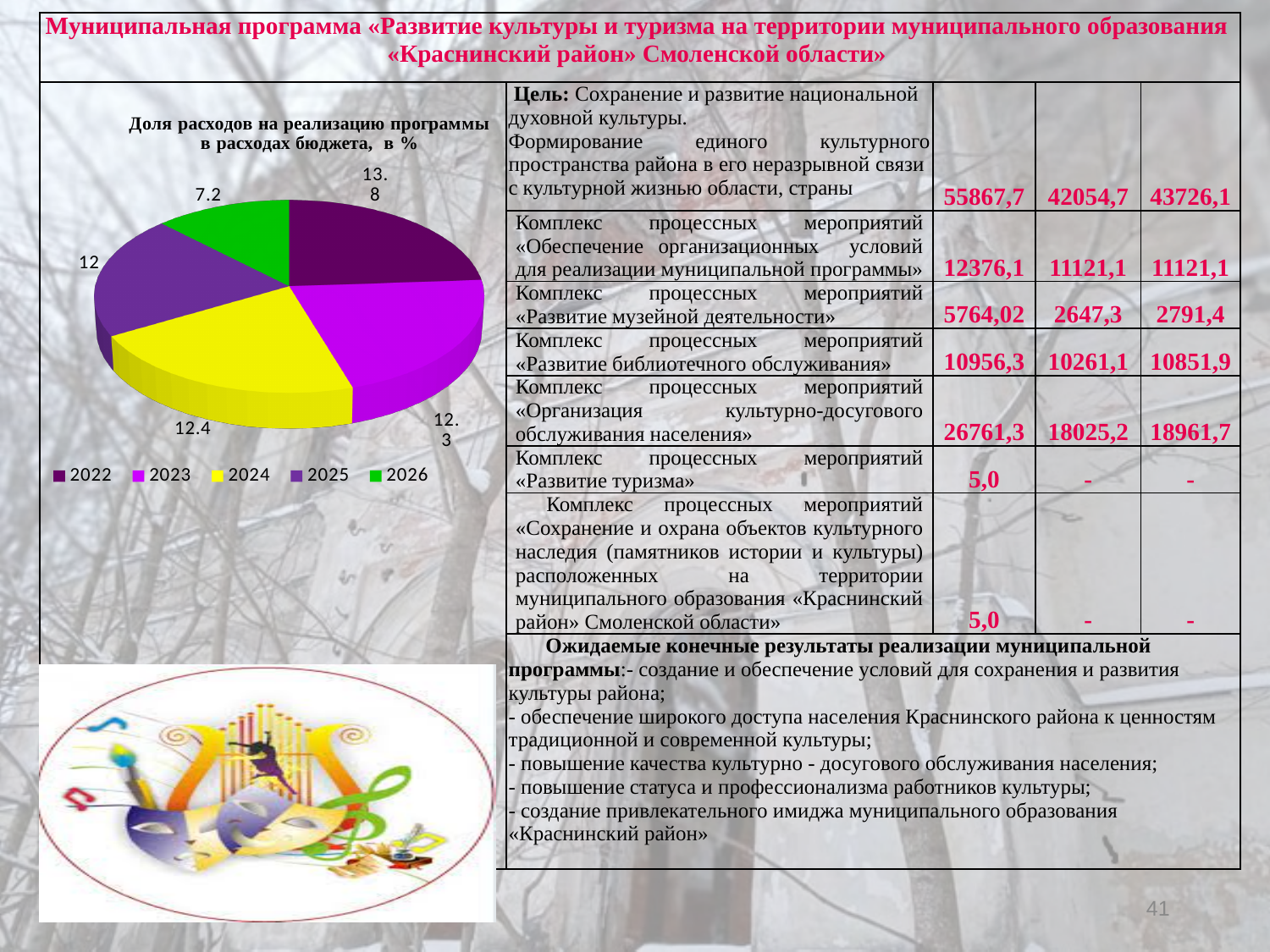
What is the value shown for 2024 in the pie chart? 12.4 What is the difference between the values for 2022 and 2026 in the pie chart? 6.6 Which year has the largest slice in the pie chart? 2022 What is the value shown for 2025 in the pie chart? 12 What is the value shown for 2022 in the pie chart? 13.8 What is the title of the pie chart? Доля расходов на реализацию программы в расходах бюджета, в % What is the value shown for 2026 in the pie chart? 7.2 How many slices does the pie chart have? 5 Which year has the smallest slice in the pie chart? 2026 What kind of chart is shown on the slide? pie chart How many series does the legend of the pie chart list? 5 Which colour represents 2024 in the pie chart? yellow